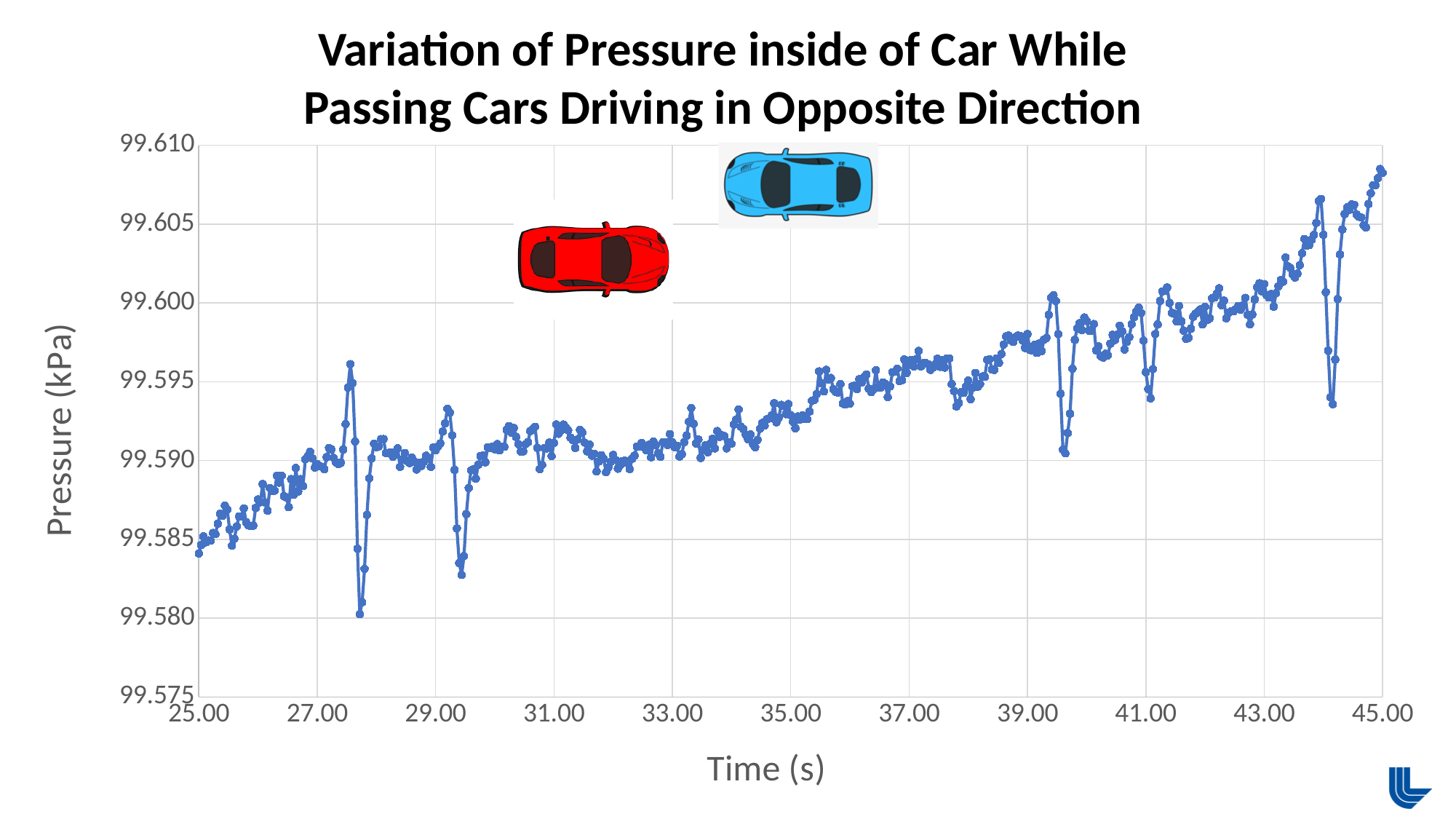
Is the pressure at 37.00 s greater or less than 99.590 kPa? greater Is the pressure at 39.00 s greater or less than 99.595 kPa? greater What is the title of the chart? Variation of Pressure inside of Car While Passing Cars Driving in Opposite Direction What is the label of the vertical axis? Pressure (kPa) Is the pressure at 25.00 s greater or less than 99.585 kPa? less Overall, does the pressure rise or fall as time increases from 25.00 s to 45.00 s? rise What kind of chart is shown on the slide? line chart Which is higher, the pressure at 25.00 s or the pressure at 45.00 s? 45.00 s